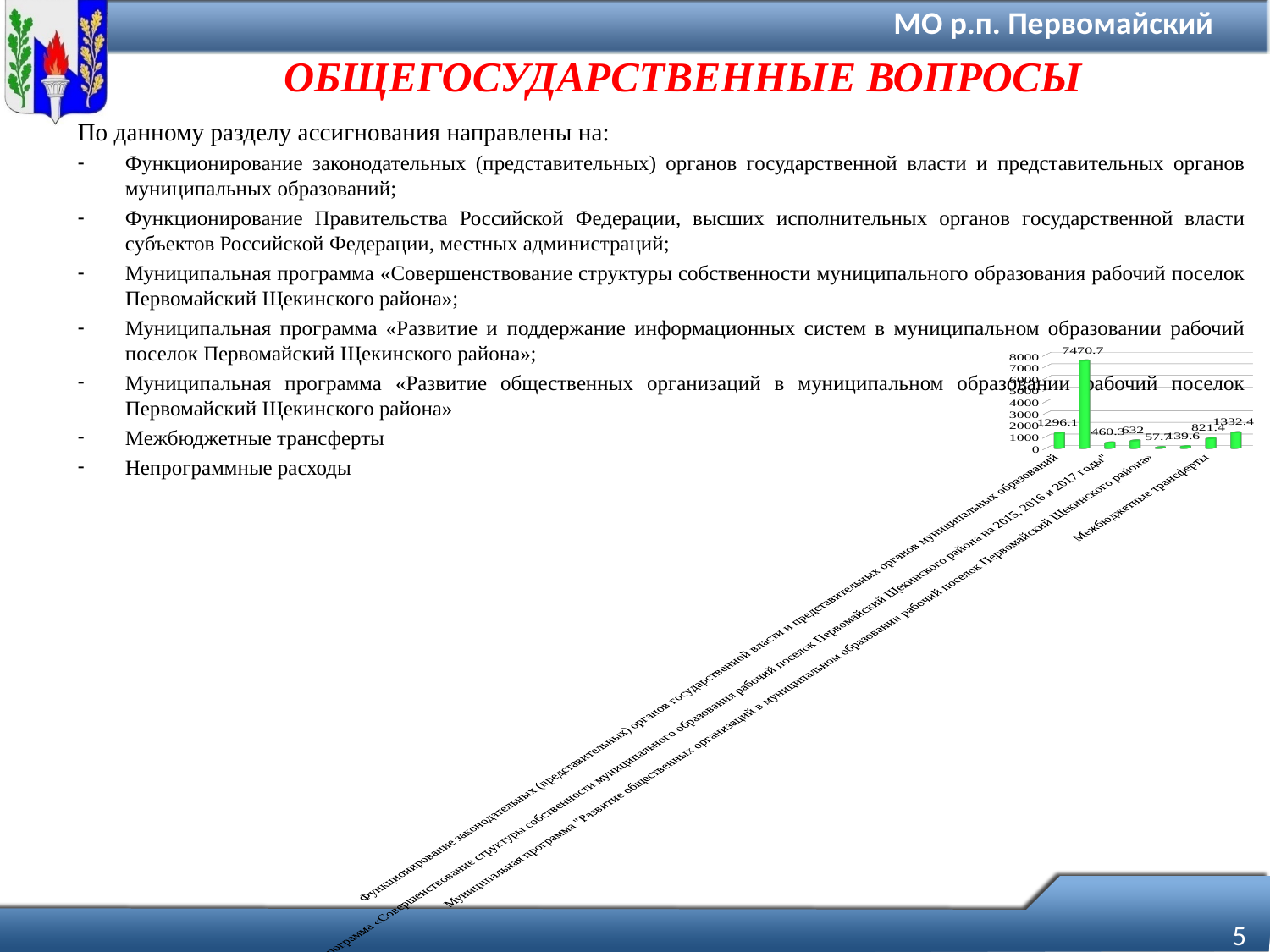
Is the tallest bar in the chart greater or less than 7000? greater What is the value of the first bar, for 'Функционирование законодательных (представительных) органов государственной власти и представительных органов муниципальных образований'? 1296.1 What kind of chart is shown on the slide? bar chart What is the value of the bar for 'Межбюджетные трансферты'? 821.4 What is the difference between the bars labelled 632 and 460.3? 171.7 Which is larger, the bar labelled 1296.1 or the bar labelled 1332.4? 1332.4 What is the highest value labelled on the chart? 7470.7 What is the lowest value labelled on the chart? 57.7 What colour are the bars in the chart? green What is the difference between the highest labelled value (7470.7) and the lowest labelled value (57.7)? 7413 How many bars are plotted in the chart? 8 What is the maximum value shown on the vertical axis of the chart? 8000